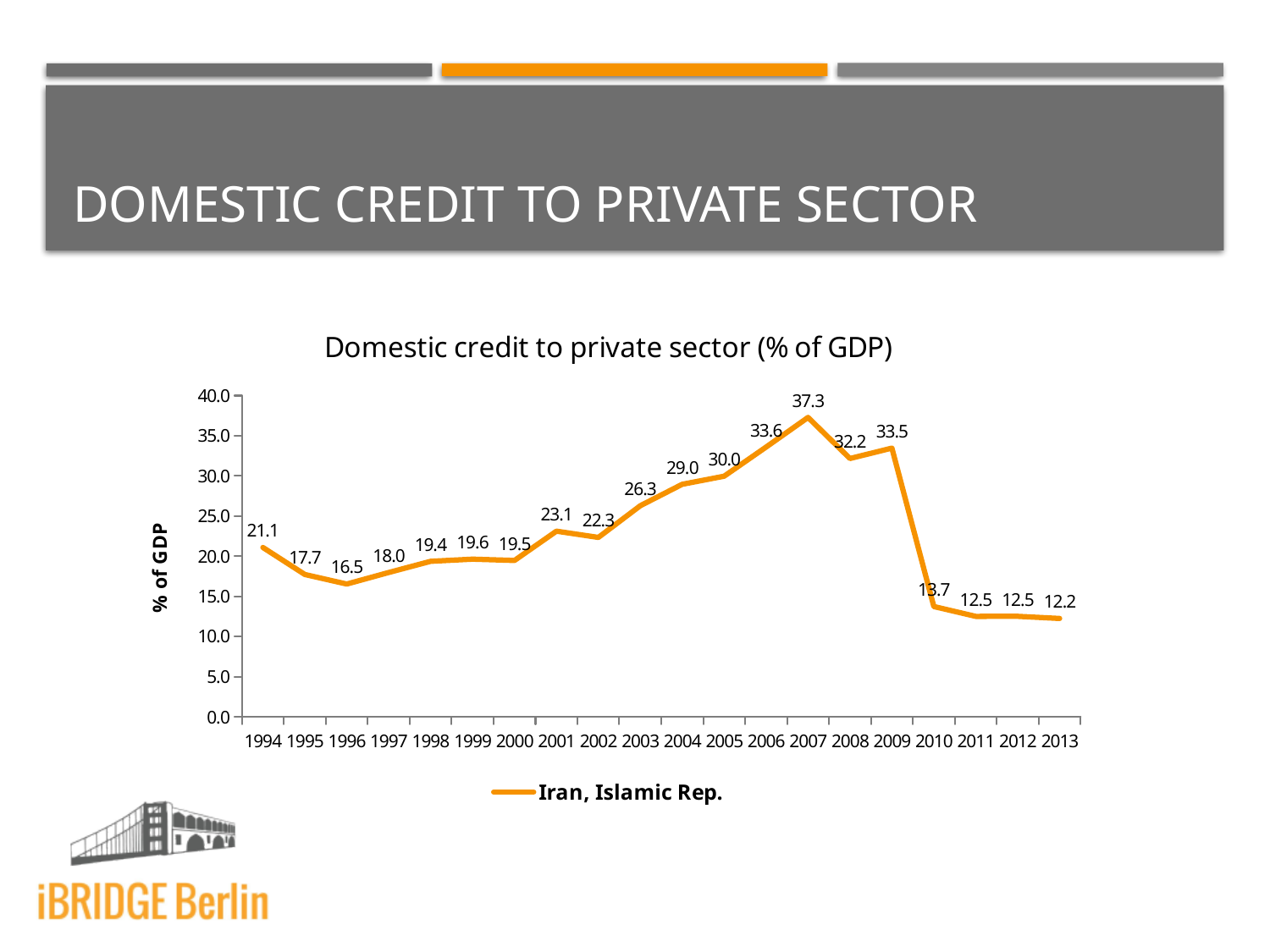
Which year has the highest value? 2007 What is the value for 2013? 12.2 What is the difference between the values for 2007 and 2013? 25.1 Which is larger, the value for 2001 or the value for 2002? 2001 How many years are plotted on the x axis? 20 What kind of chart is this? line chart Which year has the lowest value? 2013 What is the value for 1994? 21.1 What is the value for 2007? 37.3 What is the difference between the values for 2009 and 2010? 19.8 What series does the legend list? Iran, Islamic Rep. Is the value for 2006 greater or less than 30.0? greater